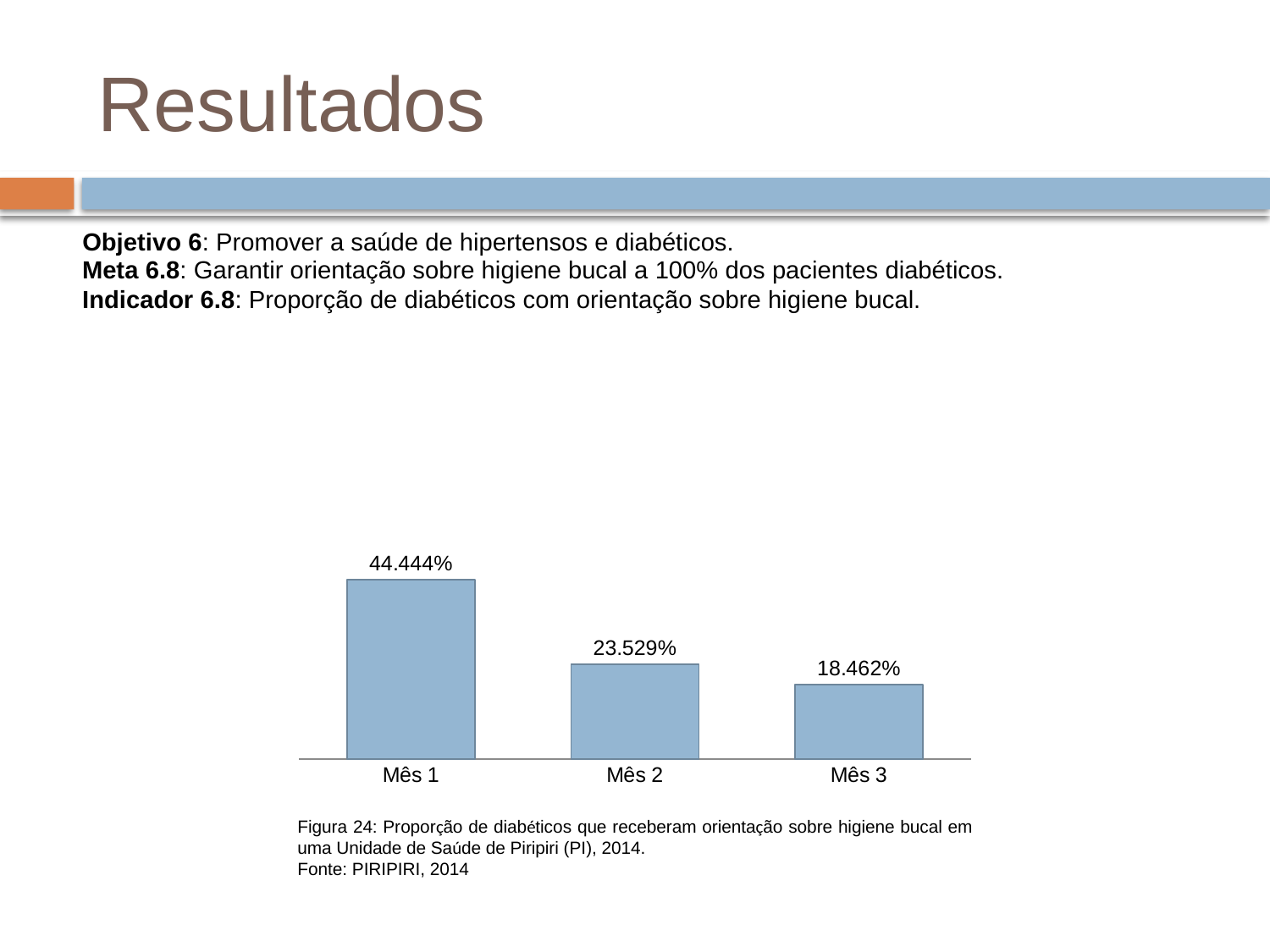
What is the difference between the values for Mês 1 and Mês 3? 25.982% What is the difference between the values for Mês 2 and Mês 3? 5.067% Which month has the highest value? Mês 1 What kind of chart is shown on the slide? Bar chart Which is larger, the value for Mês 2 or the value for Mês 3? Mês 2 How many months are shown on the chart? 3 What is the value for Mês 3? 18.462% Which month has the lowest value? Mês 3 What is the value for Mês 2? 23.529% What is the difference between the values for Mês 1 and Mês 2? 20.915% Do the values rise or fall from Mês 1 to Mês 3? Fall What is the value for Mês 1? 44.444%